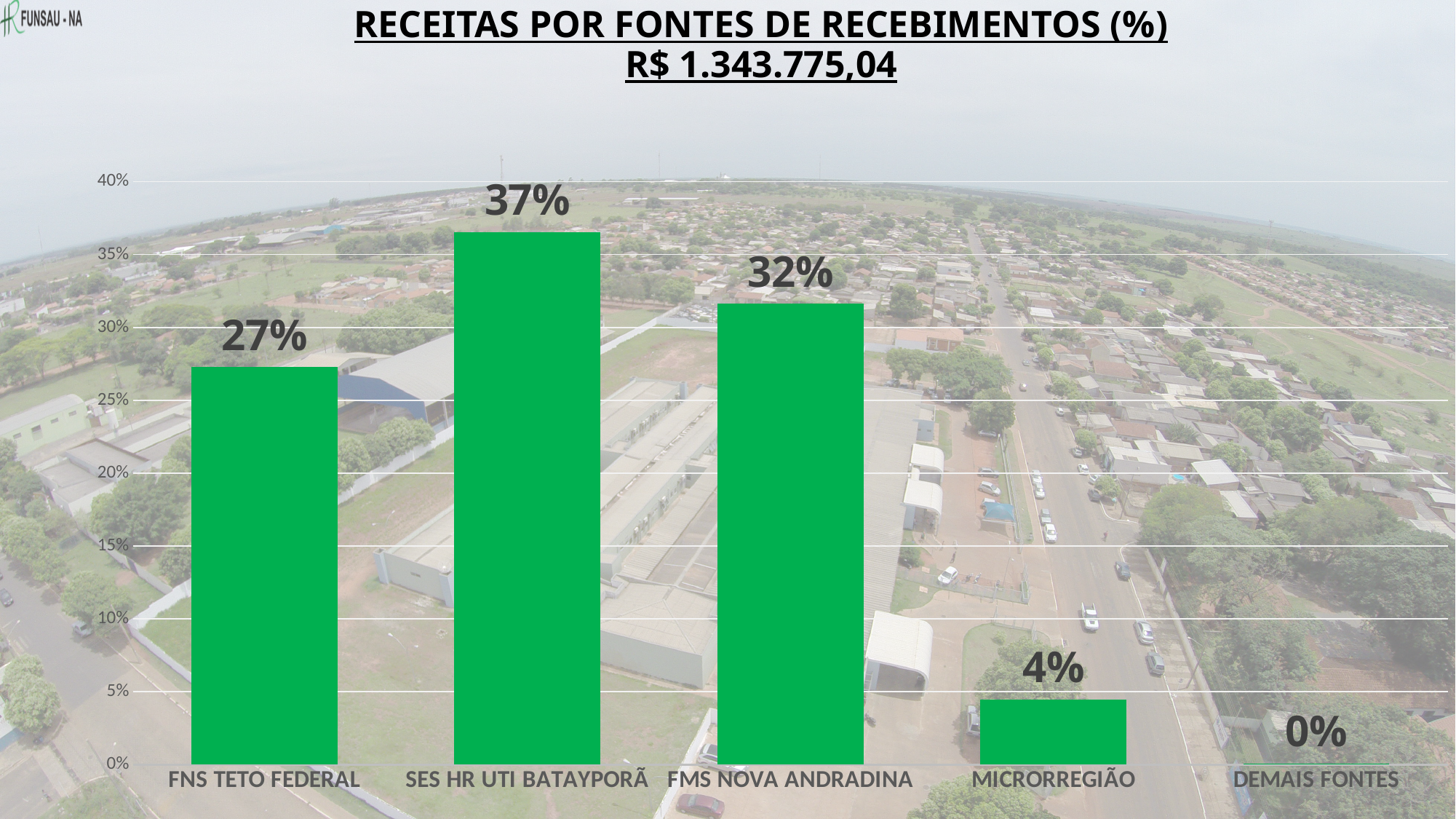
What colour are the bars in the chart? green Which category has the lowest value? DEMAIS FONTES Which is larger, the value for FMS NOVA ANDRADINA or the value for FNS TETO FEDERAL? FMS NOVA ANDRADINA Which category has the highest value? SES HR UTI BATAYPORÃ What is the difference between the values for SES HR UTI BATAYPORÃ and FMS NOVA ANDRADINA? 5% What kind of chart is shown on the slide? bar chart What is the value for DEMAIS FONTES? 0% What is the value for MICRORREGIÃO? 4% How many categories are shown on the x axis? 5 What is the value for SES HR UTI BATAYPORÃ? 37% What is the value for FNS TETO FEDERAL? 27% What is the title of the chart? RECEITAS POR FONTES DE RECEBIMENTOS (%) R$ 1.343.775,04